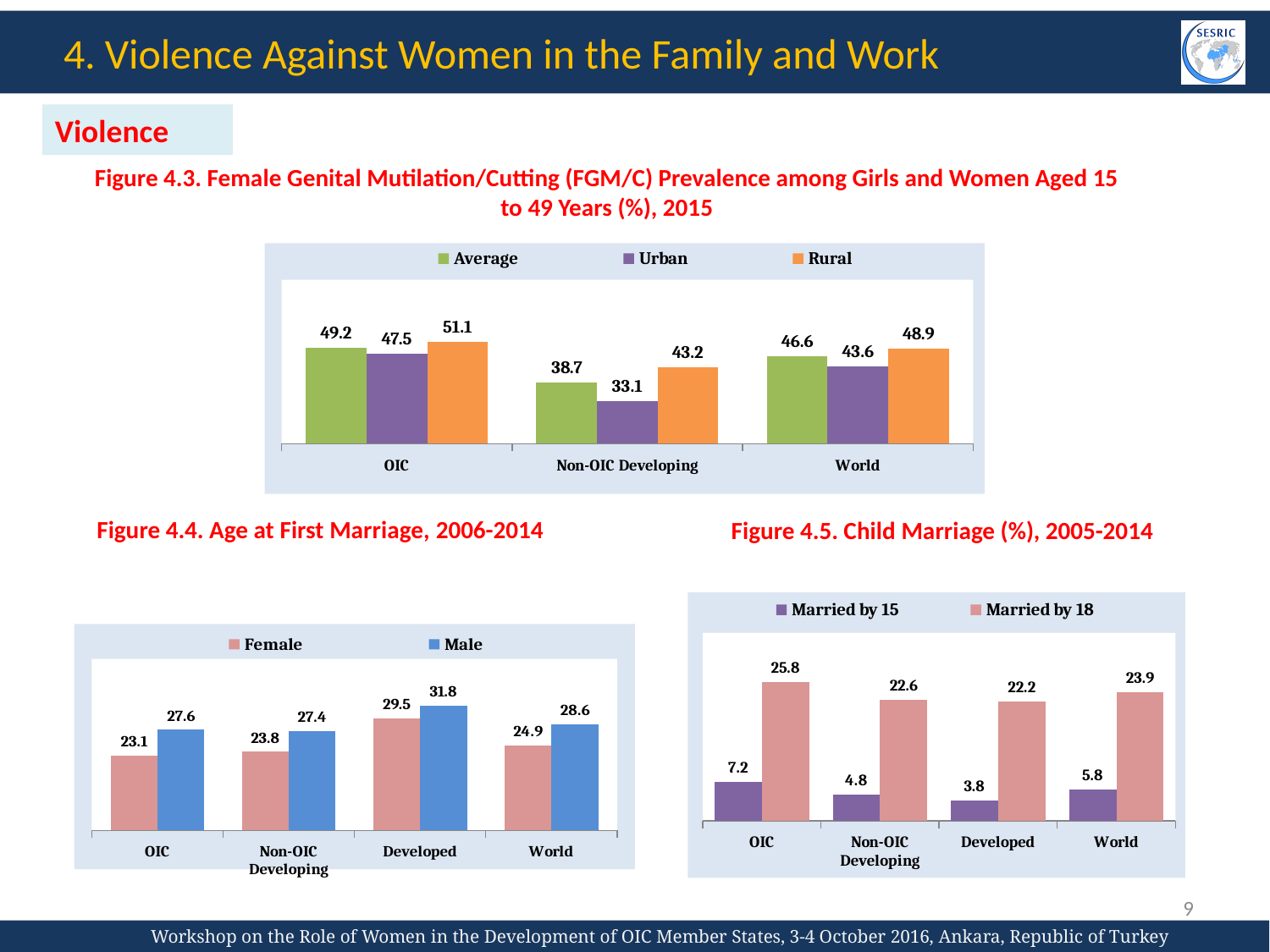
In Figure 4.4 (Age at First Marriage), what is the Male value for Developed? 31.8 What kind of chart is Figure 4.5 (Child Marriage)? Bar chart In Figure 4.4 (Age at First Marriage), which category has the highest Female value? Developed In Figure 4.4 (Age at First Marriage), how many categories are shown on the x axis? 4 In Figure 4.3 (FGM/C Prevalence), how many series does the legend list? 3 In Figure 4.5 (Child Marriage), what is the Married by 18 value for World? 23.9 In Figure 4.3 (FGM/C Prevalence), what is the Urban value for Non-OIC Developing? 33.1 In Figure 4.4 (Age at First Marriage), what is the difference between the Male and Female values for OIC? 4.5 In Figure 4.5 (Child Marriage), which category has the highest Married by 15 value? OIC In Figure 4.3 (FGM/C Prevalence), what is the difference between the Rural and Urban values for World? 5.3 In Figure 4.3 (FGM/C Prevalence), what is the Rural value for OIC? 51.1 In Figure 4.3 (FGM/C Prevalence), which category has the lowest Urban value? Non-OIC Developing